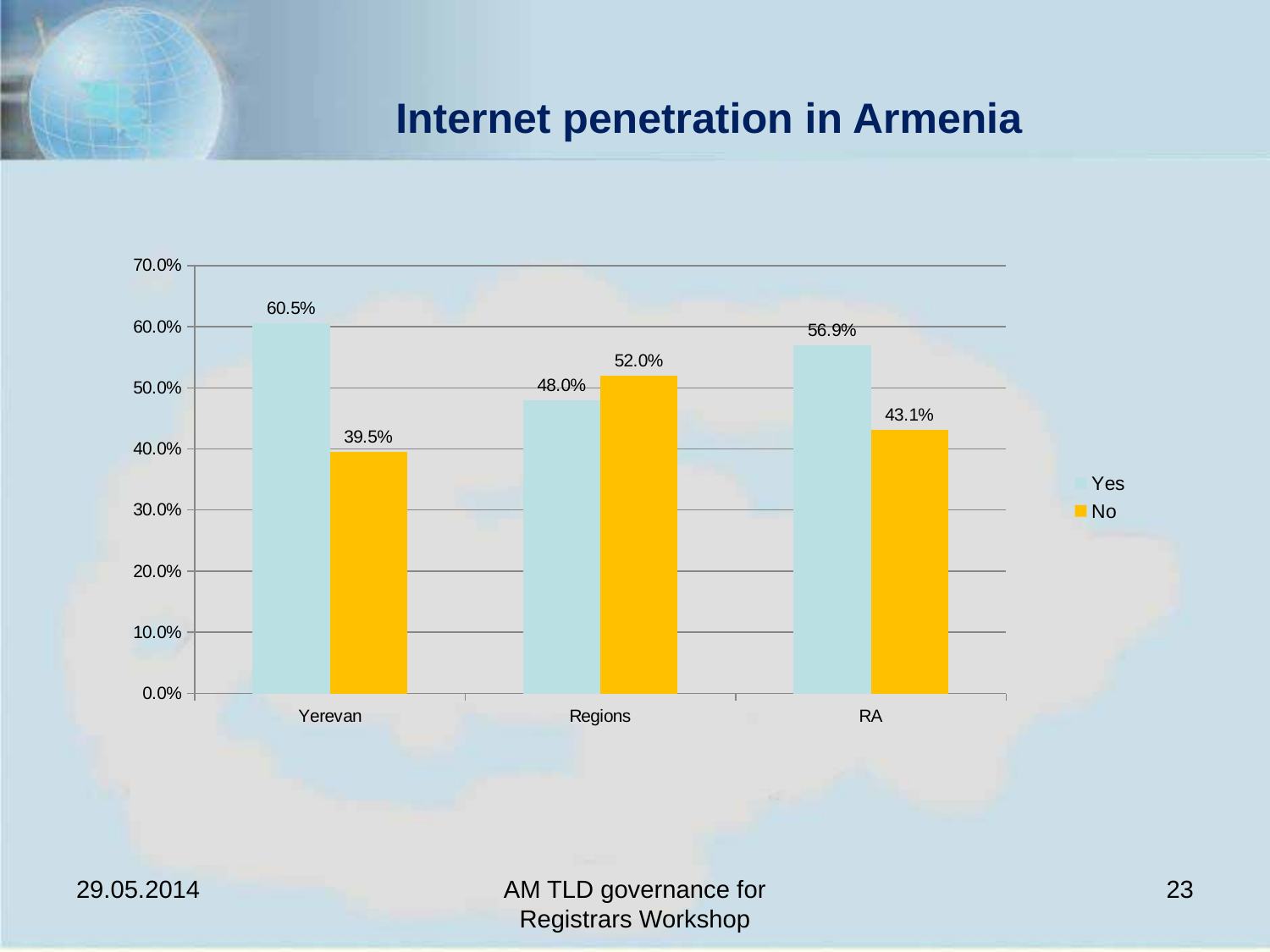
What is the 'Yes' value for Yerevan? 60.5% Which is larger for Regions, the 'Yes' value or the 'No' value? No What is the title of the slide containing the chart? Internet penetration in Armenia What kind of chart is shown on the slide? Bar chart What is the 'Yes' value for RA? 56.9% How many series does the legend list? 2 Which category has the highest 'Yes' value? Yerevan What is the 'No' value for Regions? 52.0% What is the 'No' value for RA? 43.1% What is the difference between the 'Yes' and 'No' values for Yerevan? 21.0% How many categories are shown on the x axis? 3 Which category has the lowest 'No' value? Yerevan